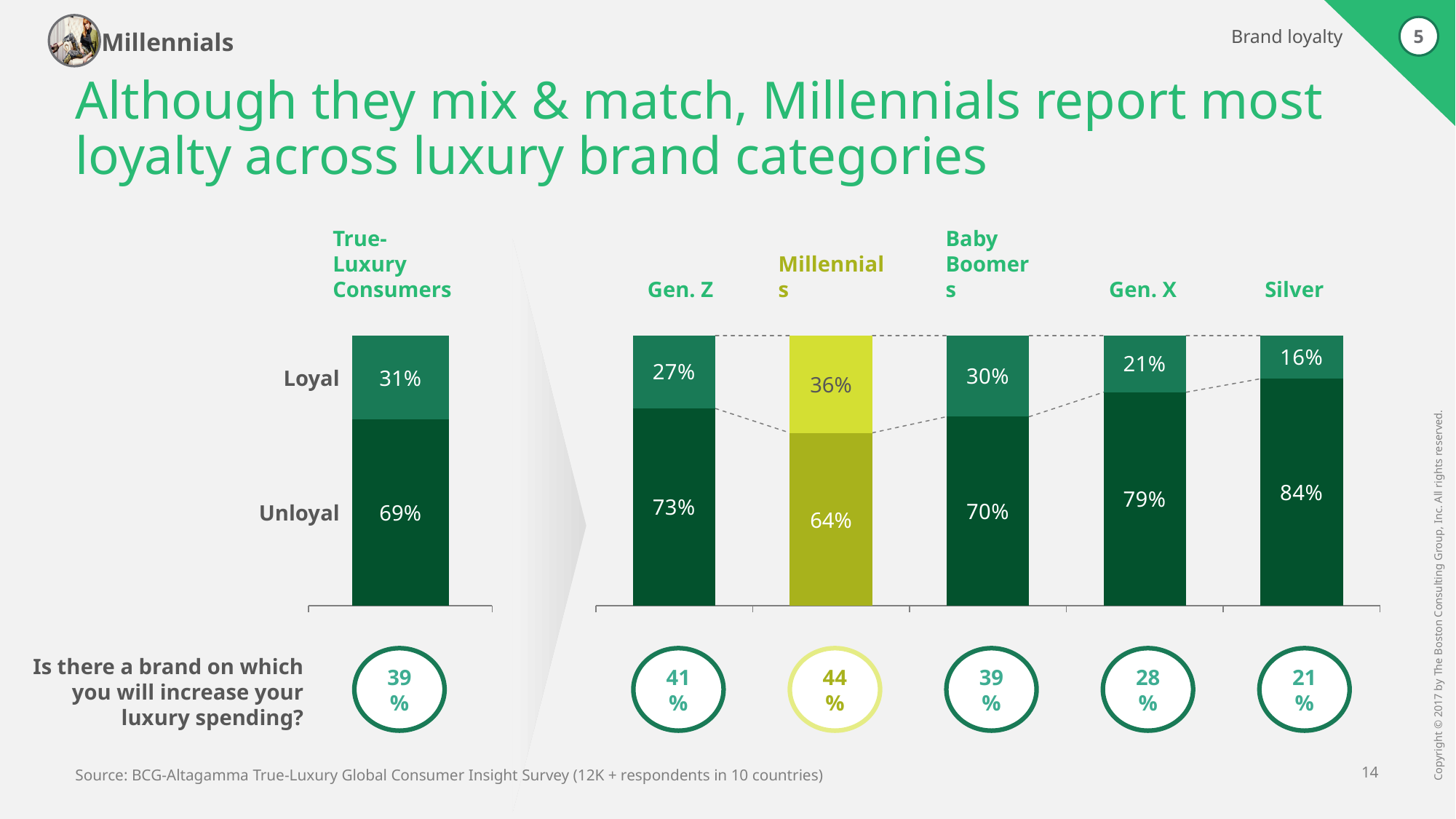
What kind of chart is used on the right-hand side to show loyalty by generation? Stacked bar chart In the right-hand chart by generation, which generation has the highest Loyal share? Millennials In the right-hand chart by generation, which generation has the lowest Loyal share? Silver In the right-hand chart by generation, what is the difference between the Unloyal shares of Silver and Millennials? 20% In the right-hand chart by generation, how many generations are shown as bars? 5 In the right-hand chart by generation, what is the Loyal share for Millennials? 36% In the right-hand chart by generation, what is the Unloyal share for Gen. X? 79% In the right-hand chart by generation, what is the Unloyal share for Silver? 84% In the left-hand True-Luxury Consumers chart, what is the Loyal share? 31% In the right-hand chart by generation, which is larger: the Loyal share for Gen. Z or for Baby Boomers? Baby Boomers In the right-hand chart by generation, which generation's bar is highlighted in yellow-green rather than dark green? Millennials In the left-hand True-Luxury Consumers chart, what is the total of the Loyal and Unloyal segments? 100%